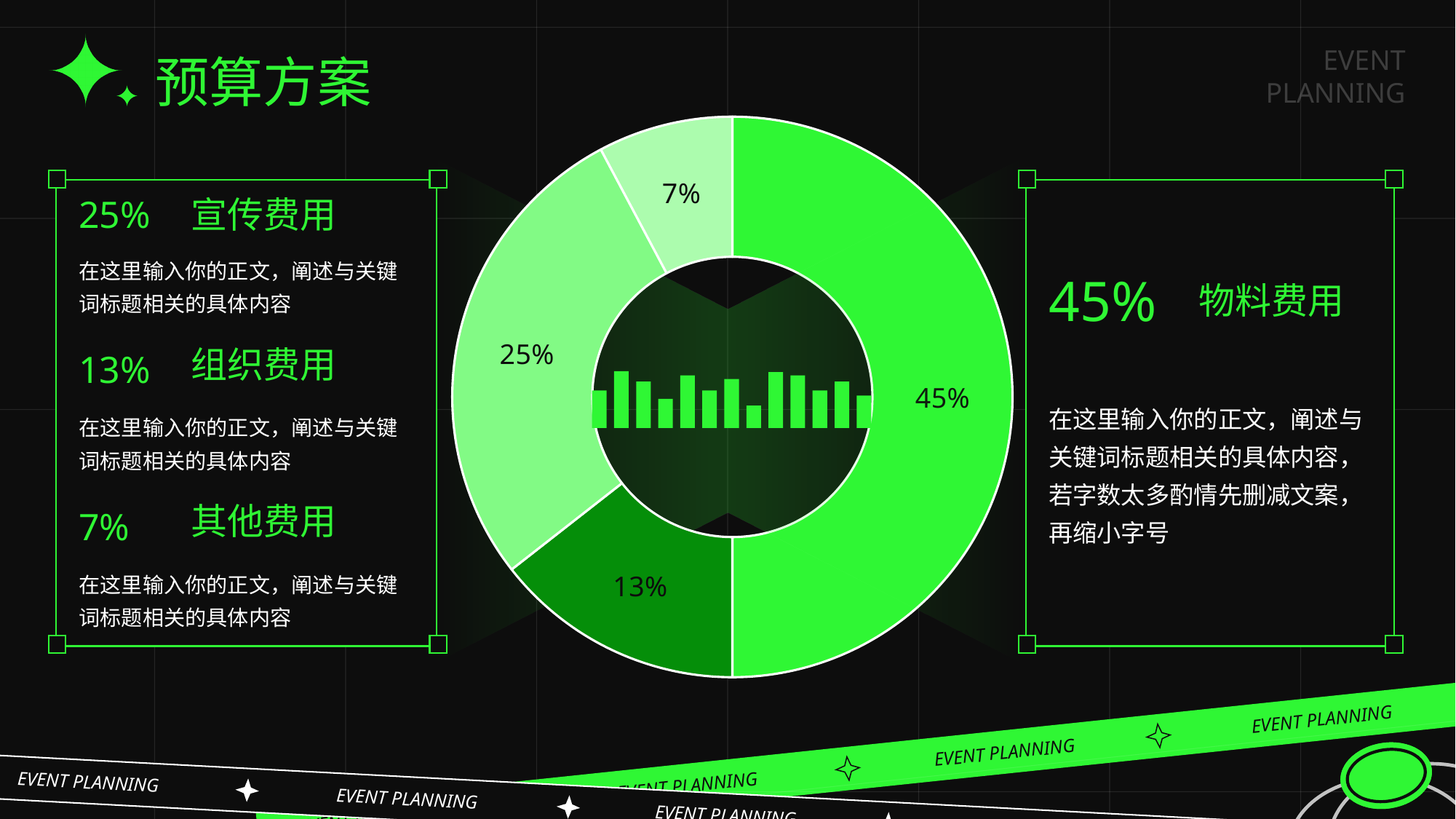
What share of the budget is 组织费用? 13% What is the difference in percentage points between 物料费用 and 宣传费用? 20 What share of the budget is 宣传费用? 25% Which is larger, the share for 组织费用 or the share for 其他费用? 组织费用 What is the title of the slide containing the chart? 预算方案 What share of the budget is 物料费用? 45% What share of the budget is 其他费用? 7% Which category has the smallest share of the budget? 其他费用 Which category has the largest share of the budget? 物料费用 What is the combined share of 宣传费用 and 组织费用? 38% How many slices does the donut chart have? 4 What kind of chart is shown on the slide? Donut (pie) chart